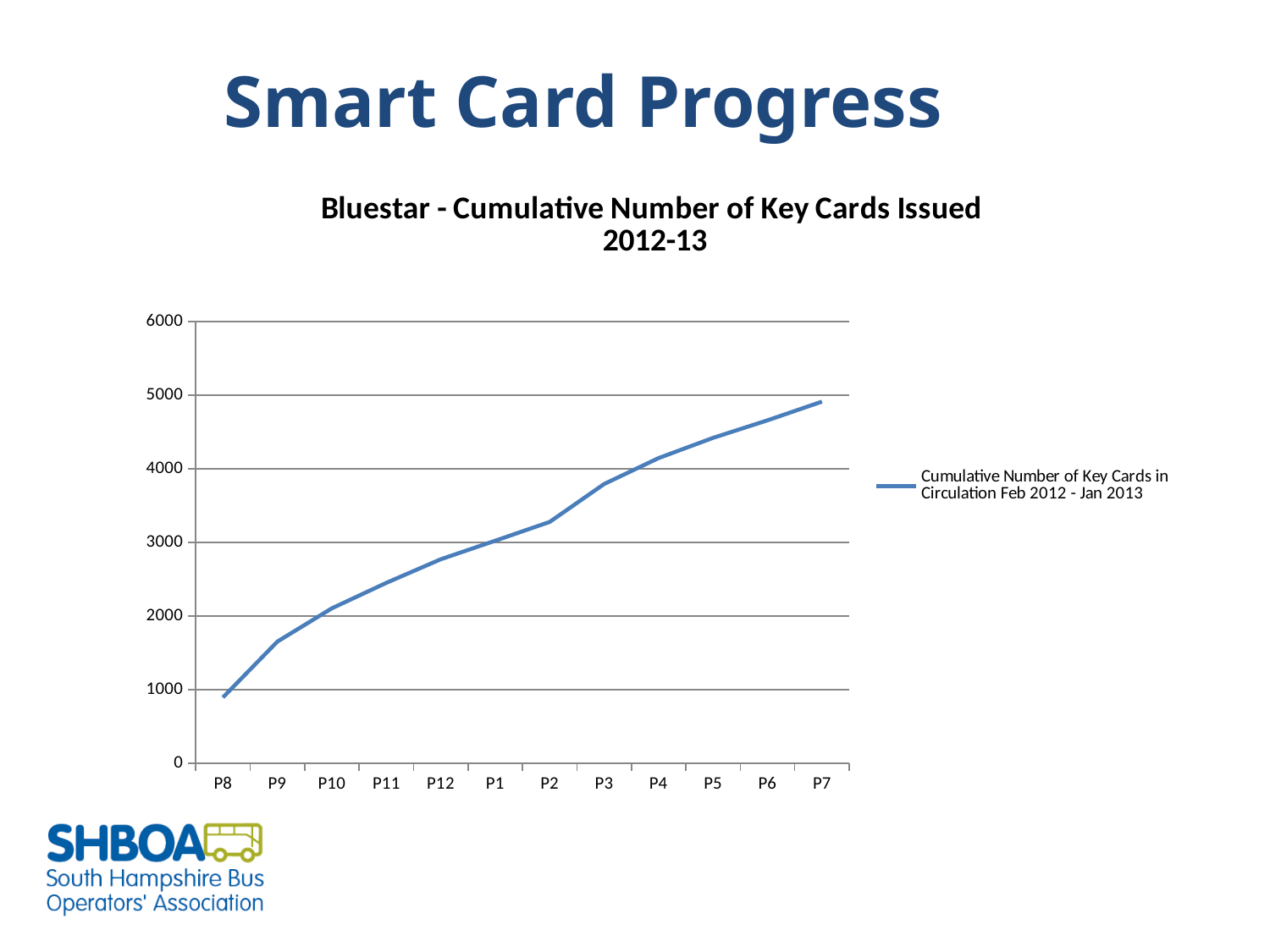
Is the value for P9 greater or less than 1000? greater How many series does the legend list? 1 Do the values rise or fall from P8 to P7? rise Is the value for P5 greater or less than 4000? greater Which period has the highest cumulative number of key cards? P7 Which period has the lowest cumulative number of key cards? P8 What kind of chart is shown on the slide? line chart Is the value for P3 greater or less than 4000? less What is the title of the chart? Bluestar - Cumulative Number of Key Cards Issued 2012-13 How many periods are plotted along the x axis? 12